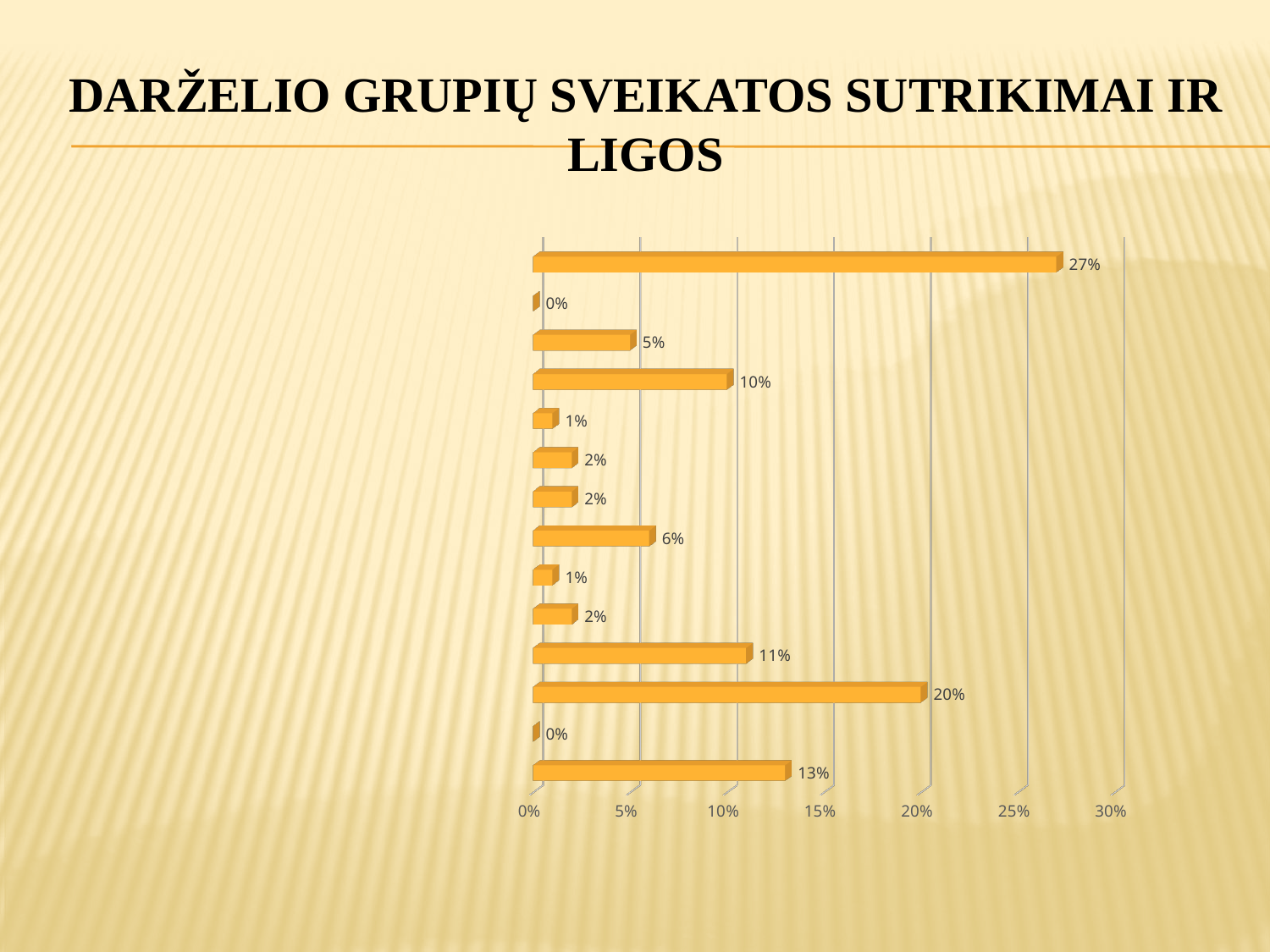
What is the value of the second bar from the bottom? 0% What is the value of the bottom bar in the chart? 13% What kind of chart is shown on the slide? bar chart How many bars are labelled 2%? 3 How many bars does the chart contain? 14 What is the title of the slide containing the chart? DARŽELIO GRUPIŲ SVEIKATOS SUTRIKIMAI IR LIGOS What is the difference between the topmost bar (27%) and the bottom bar (13%)? 14% Which is larger, the topmost bar or the bottom bar? the topmost bar What is the value of the topmost bar in the chart? 27% What is the highest value shown by any bar in the chart? 27% What is the largest value marked on the horizontal axis? 30% What is the lowest value shown by any bar in the chart? 0%